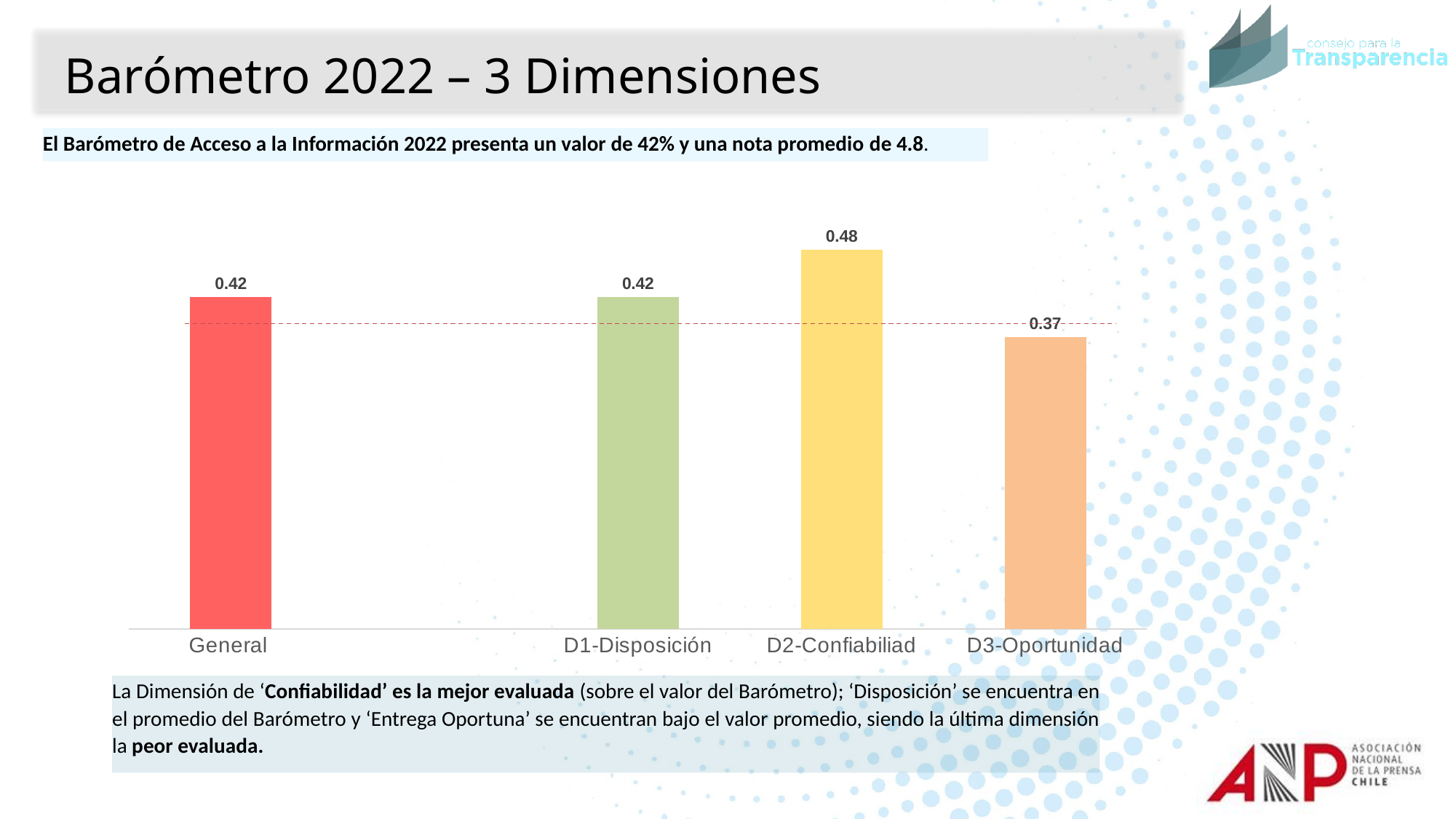
What kind of chart is shown on the slide? Bar chart What colour is the bar for D2-Confiabiliad? Yellow What is the difference between the values for D2-Confiabiliad and D3-Oportunidad? 0.11 What is the value for D3-Oportunidad? 0.37 What is the value for General? 0.42 Which category has the lowest value? D3-Oportunidad What is the value for D2-Confiabiliad? 0.48 What is the value for D1-Disposición? 0.42 How many bars are shown in the chart? 4 Which category has the highest value? D2-Confiabiliad Which is larger, the value for D1-Disposición or the value for D3-Oportunidad? D1-Disposición What is the difference between the values for D2-Confiabiliad and General? 0.06